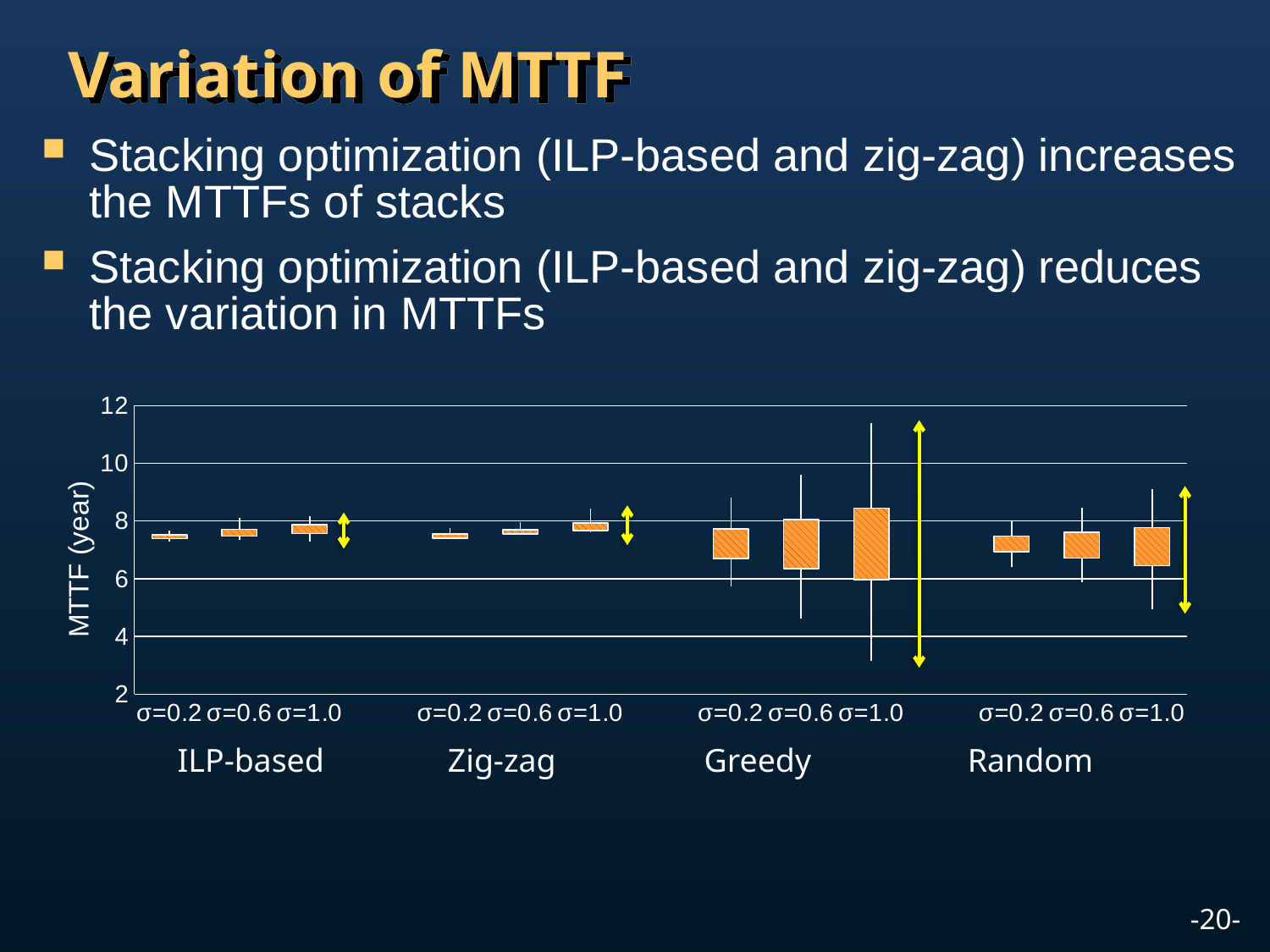
Is the bottom of the lower whisker for Greedy at σ=1.0 greater or less than 4? less Is the top of the upper whisker for Greedy at σ=1.0 greater or less than 10? greater What kind of chart is shown on the slide? Box-and-whisker (box plot) chart What are the lowest and highest tick values shown on the y axis? 2 and 12 What is the label of the y axis of the chart? MTTF (year) Which shows a wider spread of MTTF values, Greedy or Random? Greedy How many boxes (σ settings in total) are plotted in the chart? 12 Which stacking method shows the widest spread of MTTF values in the chart? Greedy How many stacking methods are compared along the x axis of the chart? 4 Which σ values are plotted for each stacking method? σ=0.2, σ=0.6, σ=1.0 Is the box for ILP-based at σ=0.2 greater or less than 8? less